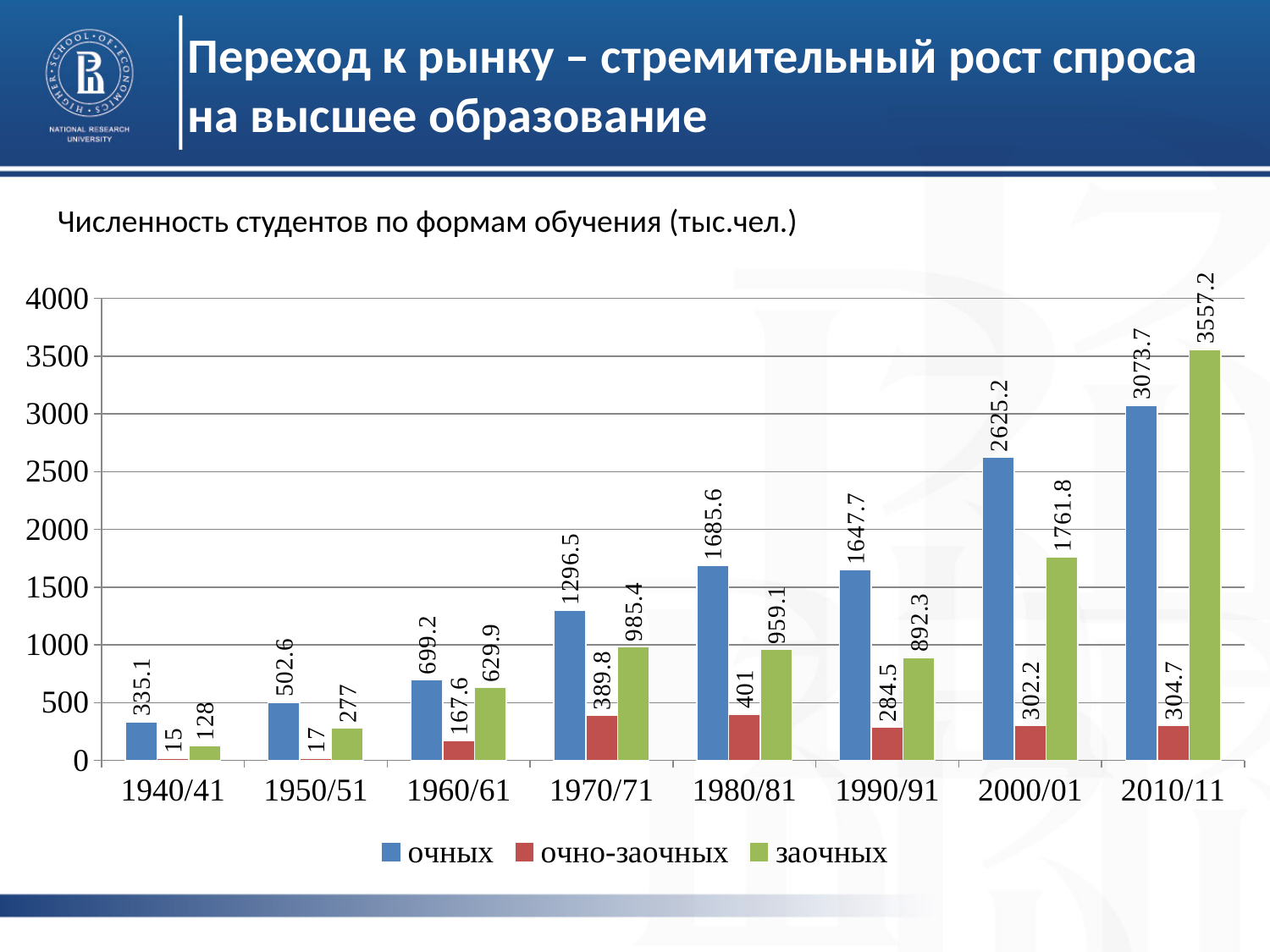
In which year is the value for заочных the highest? 2010/11 What is the value for заочных in 1970/71? 985.4 What is the value for очных in 2010/11? 3073.7 What is the title of the chart? Численность студентов по формам обучения (тыс.чел.) How many academic years are shown on the x axis? 8 What is the difference between очных and заочных in 2000/01? 863.4 Which is larger in 2010/11: очных or заочных? заочных How many series does the legend list? 3 In which year is the value for очно-заочных the lowest? 1940/41 Is the value for очных in 1980/81 greater or less than 1500? greater What type of chart is shown on the slide? bar chart What is the value for очно-заочных in 1940/41? 15